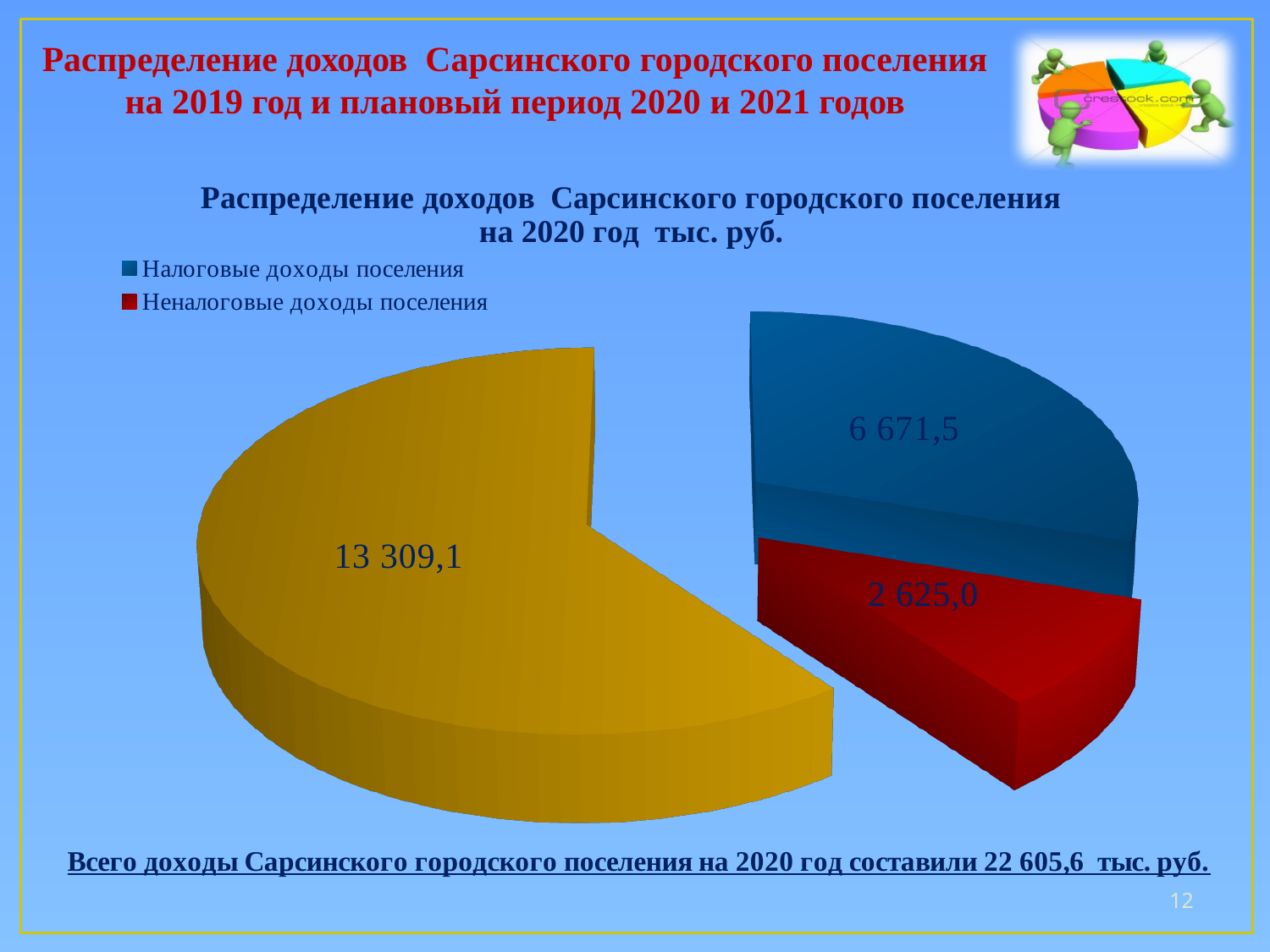
What type of chart is shown on the slide? pie chart What is the sum of the three values printed on the pie slices? 22 605,6 How many entries does the legend list? 2 What is the difference between Налоговые доходы поселения and Неналоговые доходы поселения? 4 046,5 What is the value for Неналоговые доходы поселения? 2 625,0 How many slices does the pie chart have? 3 What is the value for Налоговые доходы поселения? 6 671,5 Which is larger, Налоговые доходы поселения or Неналоговые доходы поселения? Налоговые доходы поселения What is the largest value printed on any slice of the pie? 13 309,1 What colour is the slice for Налоговые доходы поселения? blue What value is printed on the yellow slice of the pie? 13 309,1 Which of the two legend categories has the smallest slice? Неналоговые доходы поселения